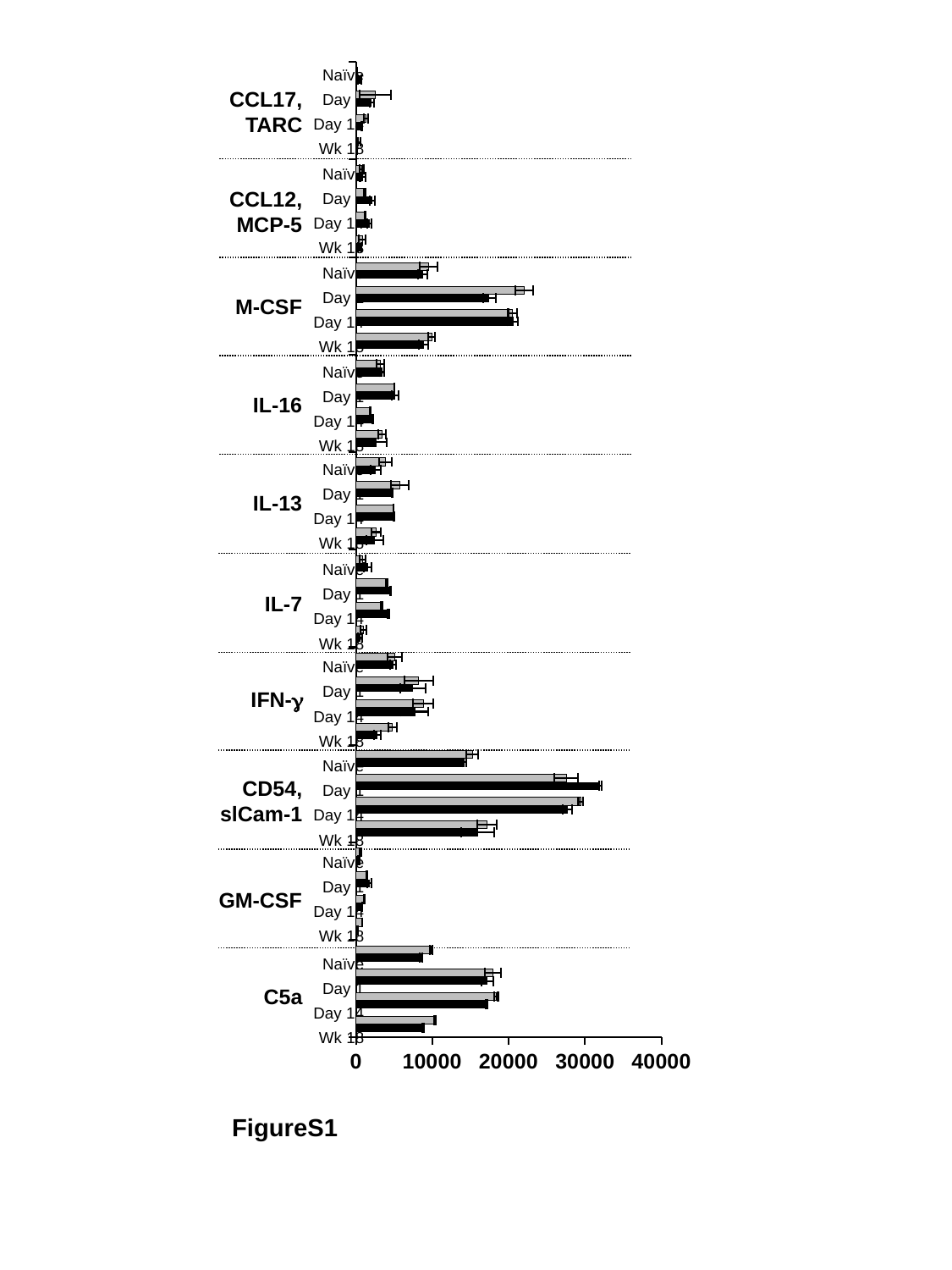
Which has larger Naïve bars, CD54, sICam-1 or IL-7? CD54, sICam-1 Are the Day bars of CD54, sICam-1 greater or less than 20000? greater What kind of chart is shown on the slide? bar chart What is the figure label printed below the chart? FigureS1 How many analyte groups (e.g. CCL17/TARC, M-CSF, C5a) are labelled along the left side of the chart? 10 Which has larger Day bars, M-CSF or IL-16? M-CSF Is the value for the Naïve bars of M-CSF greater or less than 10000? less Are the Naïve bars of GM-CSF greater or less than 10000? less What is the highest value shown on the horizontal axis? 40000 Which analyte group has the longest bars in the chart? CD54, sICam-1